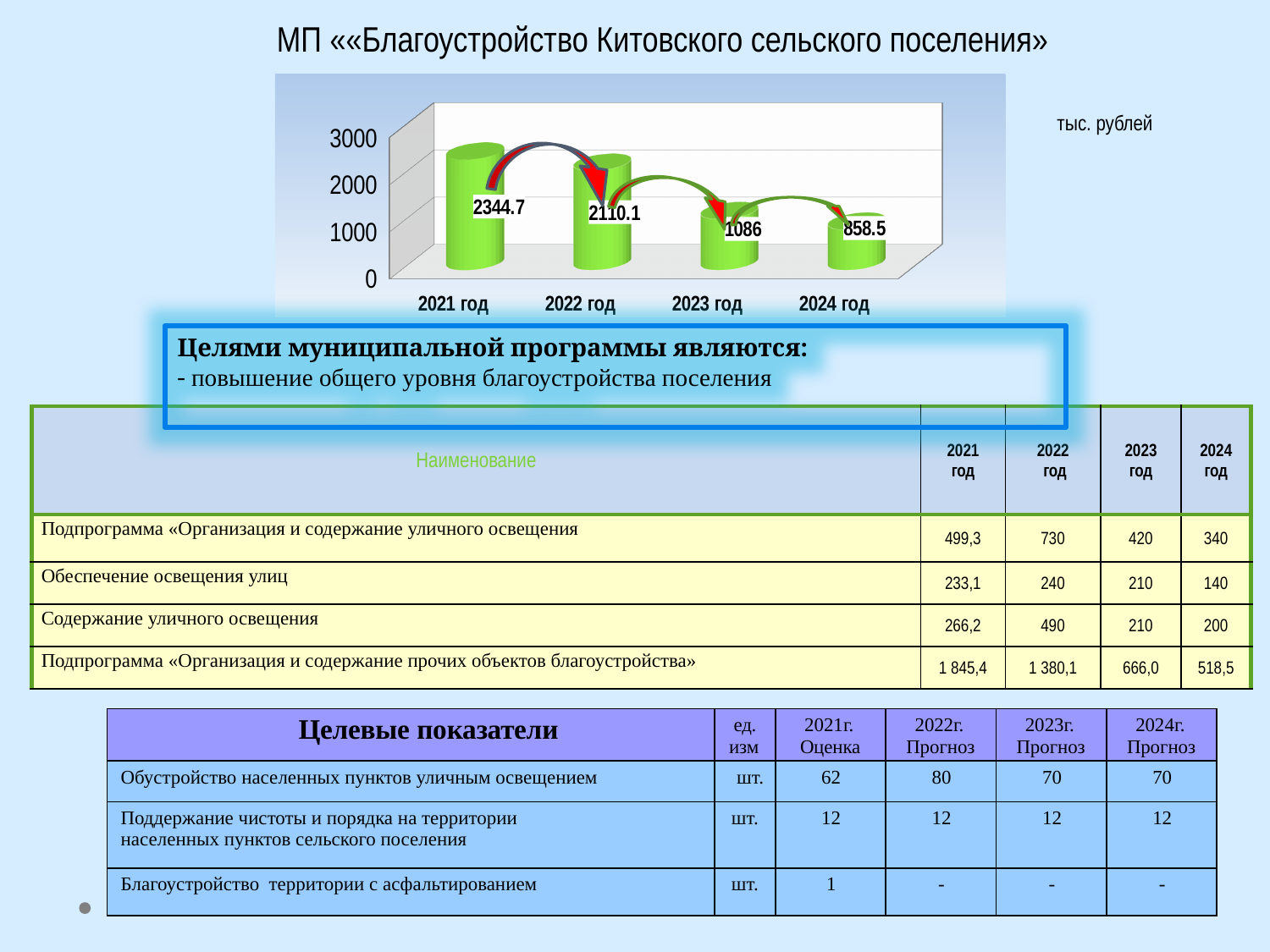
What kind of chart is shown on the slide? bar chart What is the difference between the values for 2021 год and 2022 год? 234.6 Which year has the lowest value on the chart? 2024 год Which is larger, the value for 2023 год or the value for 2024 год? 2023 год What is the value shown for 2023 год on the chart? 1086 How many years are plotted on the chart? 4 Which year has the highest value on the chart? 2021 год Do the values rise or fall from 2021 год to 2024 год? fall What is the difference between the values for 2022 год and 2023 год? 1024.1 What is the value shown for 2022 год on the chart? 2110.1 What is the value shown for 2021 год on the chart? 2344.7 What is the value shown for 2024 год on the chart? 858.5